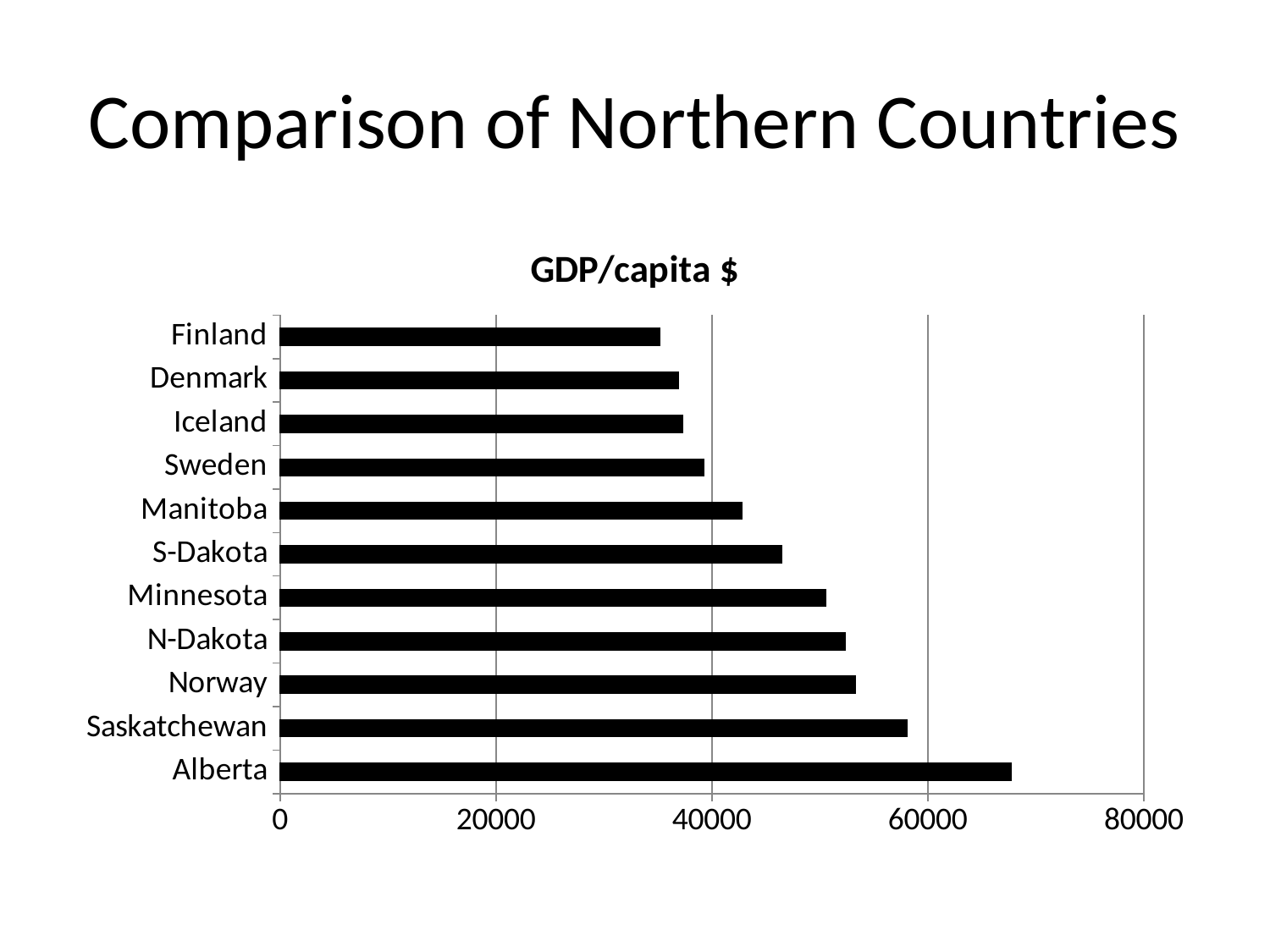
What colour are the bars in the chart? black Is the value for Finland greater or less than 40000? less Which country or region has the lowest GDP/capita in the chart? Finland Which country or region has the highest GDP/capita in the chart? Alberta What kind of chart is shown on the slide? bar chart Is the value for Alberta greater or less than 60000? greater Is the value for Minnesota greater or less than 40000? greater Which has a higher GDP/capita, Manitoba or Sweden? Manitoba What is the title of the chart? GDP/capita $ How many countries or regions are plotted in the chart? 11 Which has a higher GDP/capita, Alberta or Norway? Alberta